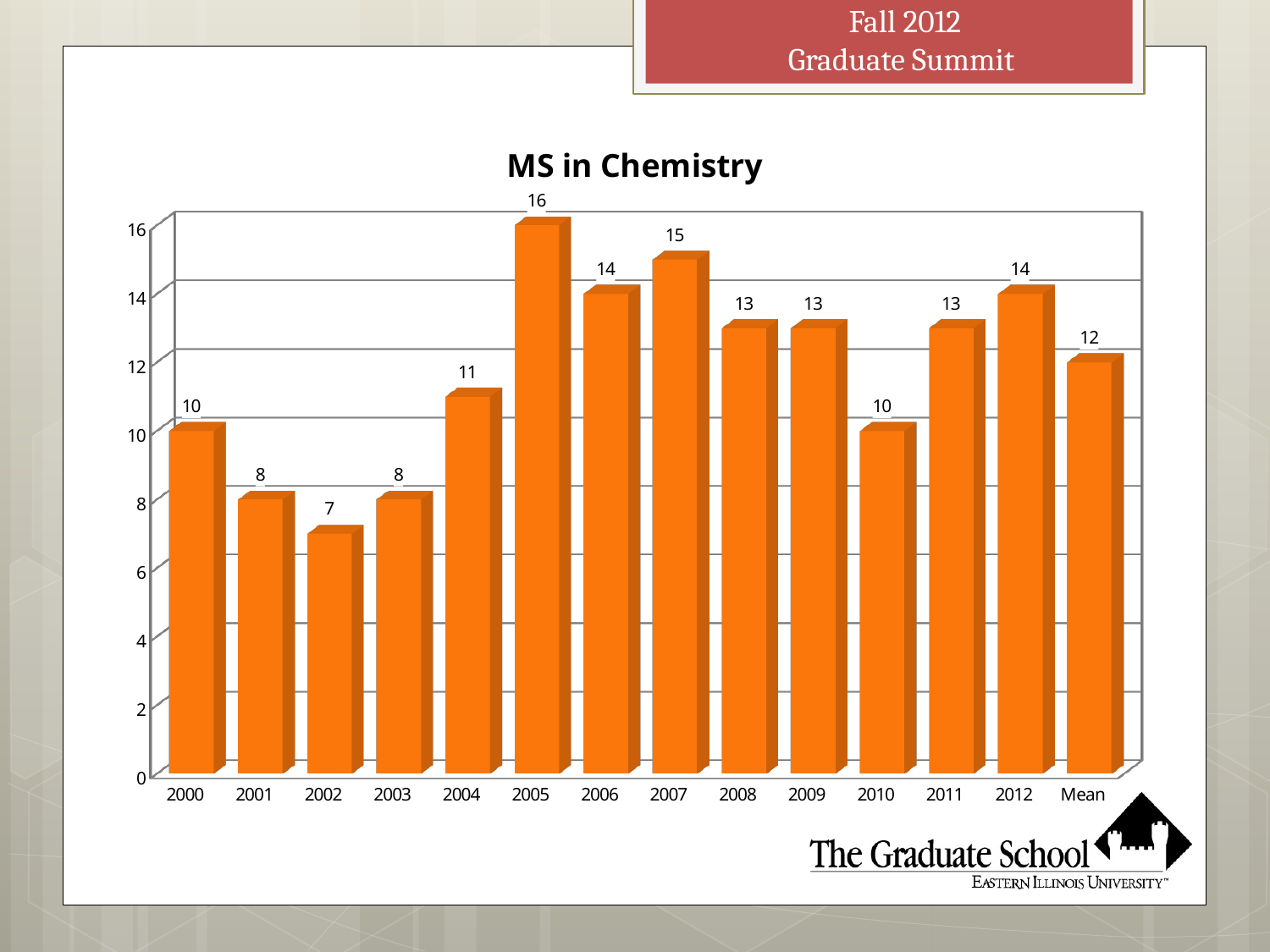
What is the difference between the values for 2005 and 2002 in the MS in Chemistry chart? 9 Do the values in the MS in Chemistry chart rise or fall from 2002 to 2005? rise What is the Mean value shown in the MS in Chemistry chart? 12 Which year has the lowest value in the MS in Chemistry chart? 2002 Is the value for 2012 in the MS in Chemistry chart greater or less than 10? greater What kind of chart is the MS in Chemistry chart? bar chart Which year has the highest value in the MS in Chemistry chart? 2005 What is the value for 2010 in the MS in Chemistry chart? 10 How many bars are shown in the MS in Chemistry chart, including the Mean bar? 14 What is the value for 2005 in the MS in Chemistry chart? 16 Which is larger in the MS in Chemistry chart, the value for 2000 or the value for 2004? 2004 What is the difference between the values for 2007 and 2004 in the MS in Chemistry chart? 4